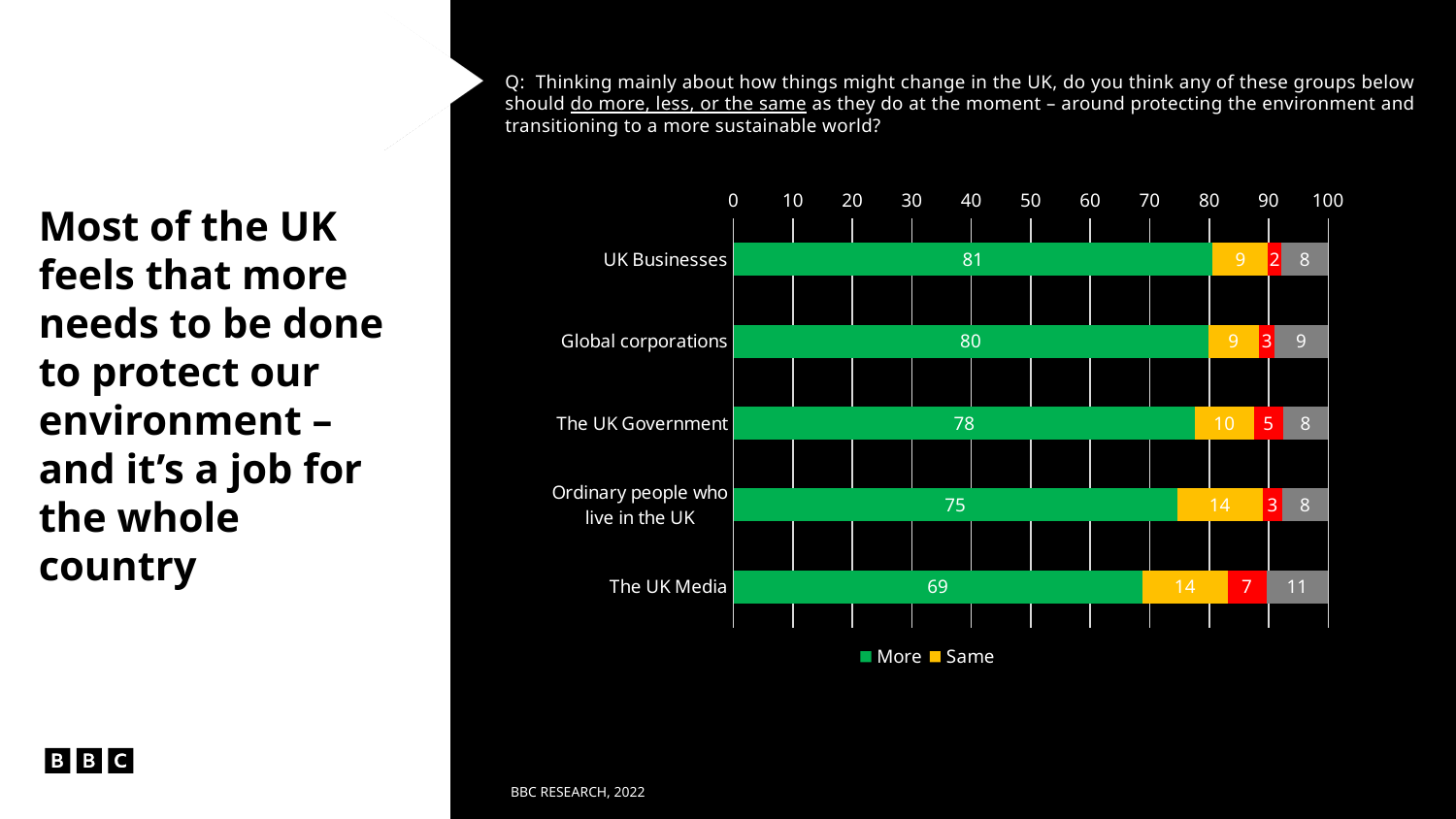
What percentage of respondents say UK Businesses should do more? 81 What is the 'Same' value for The UK Government? 10 How many groups are shown on the chart? 5 What is the 'More' value for The UK Media? 69 Which group has the highest 'More' value? UK Businesses Which has a larger 'More' value, The UK Government or Ordinary people who live in the UK? The UK Government What kind of chart is shown on the slide? Stacked bar chart What is the total of all segments in the UK Businesses bar? 100 What is the difference between the 'More' values for UK Businesses and The UK Media? 12 How many series does the legend list? 2 Which group has the lowest 'More' value? The UK Media What is the 'Same' value for Ordinary people who live in the UK? 14